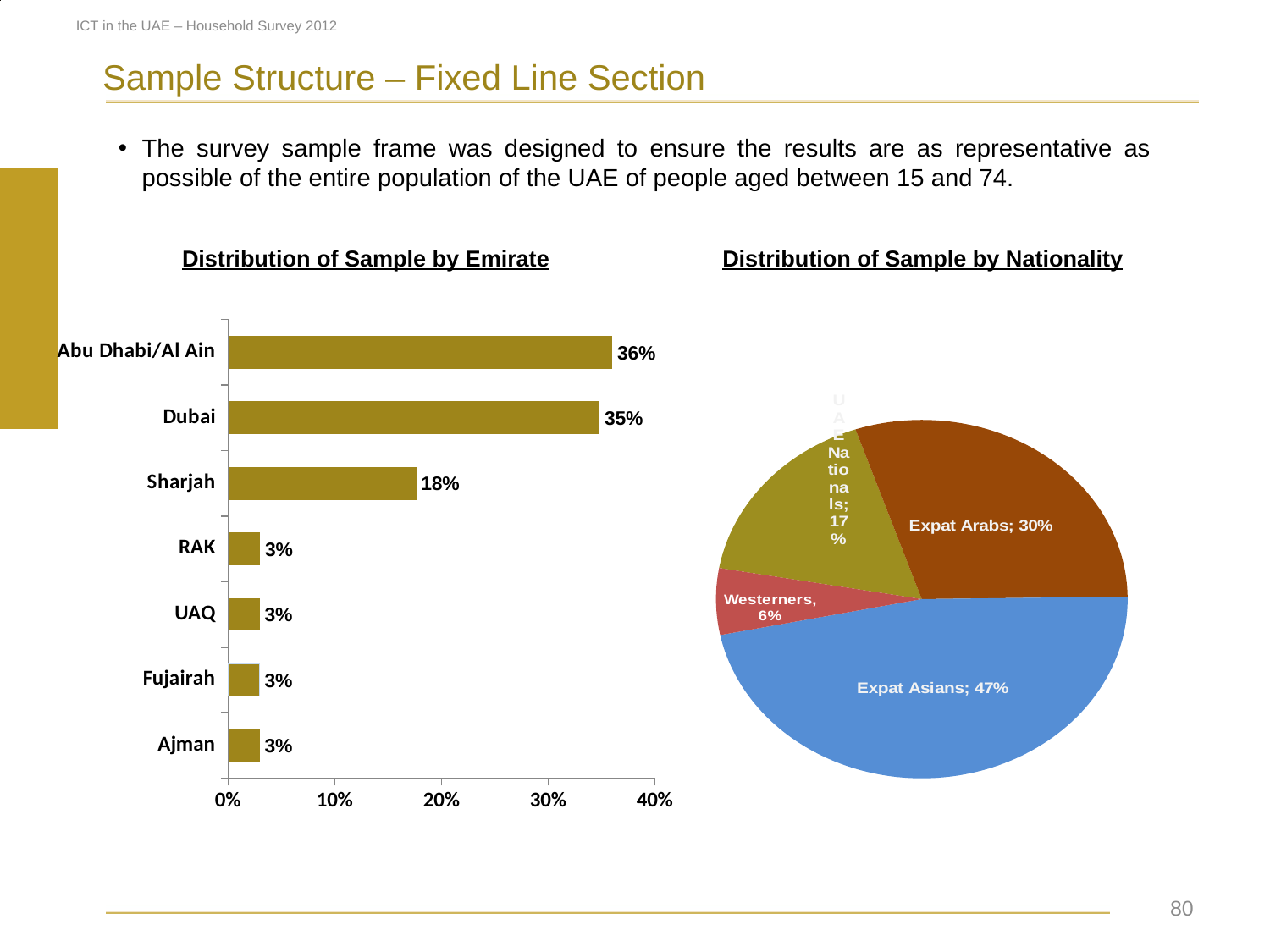
In the Distribution of Sample by Nationality chart, what share is Westerners? 6% In the Distribution of Sample by Emirate chart, is the value for Abu Dhabi/Al Ain greater or less than 30%? greater In the Distribution of Sample by Emirate chart, what is the difference between Abu Dhabi/Al Ain and Sharjah? 18% In the Distribution of Sample by Nationality chart, what share is Expat Asians? 47% In the Distribution of Sample by Emirate chart, how many emirates are shown? 7 In the Distribution of Sample by Emirate chart, what is the value for Dubai? 35% In the Distribution of Sample by Nationality chart, which nationality group has the smallest slice? Westerners What kind of chart is the Distribution of Sample by Emirate chart? Bar chart In the Distribution of Sample by Emirate chart, what is the value for Sharjah? 18% In the Distribution of Sample by Emirate chart, which is larger, Dubai or Sharjah? Dubai In the Distribution of Sample by Emirate chart, which emirate has the highest value? Abu Dhabi/Al Ain What kind of chart is the Distribution of Sample by Nationality chart? Pie chart